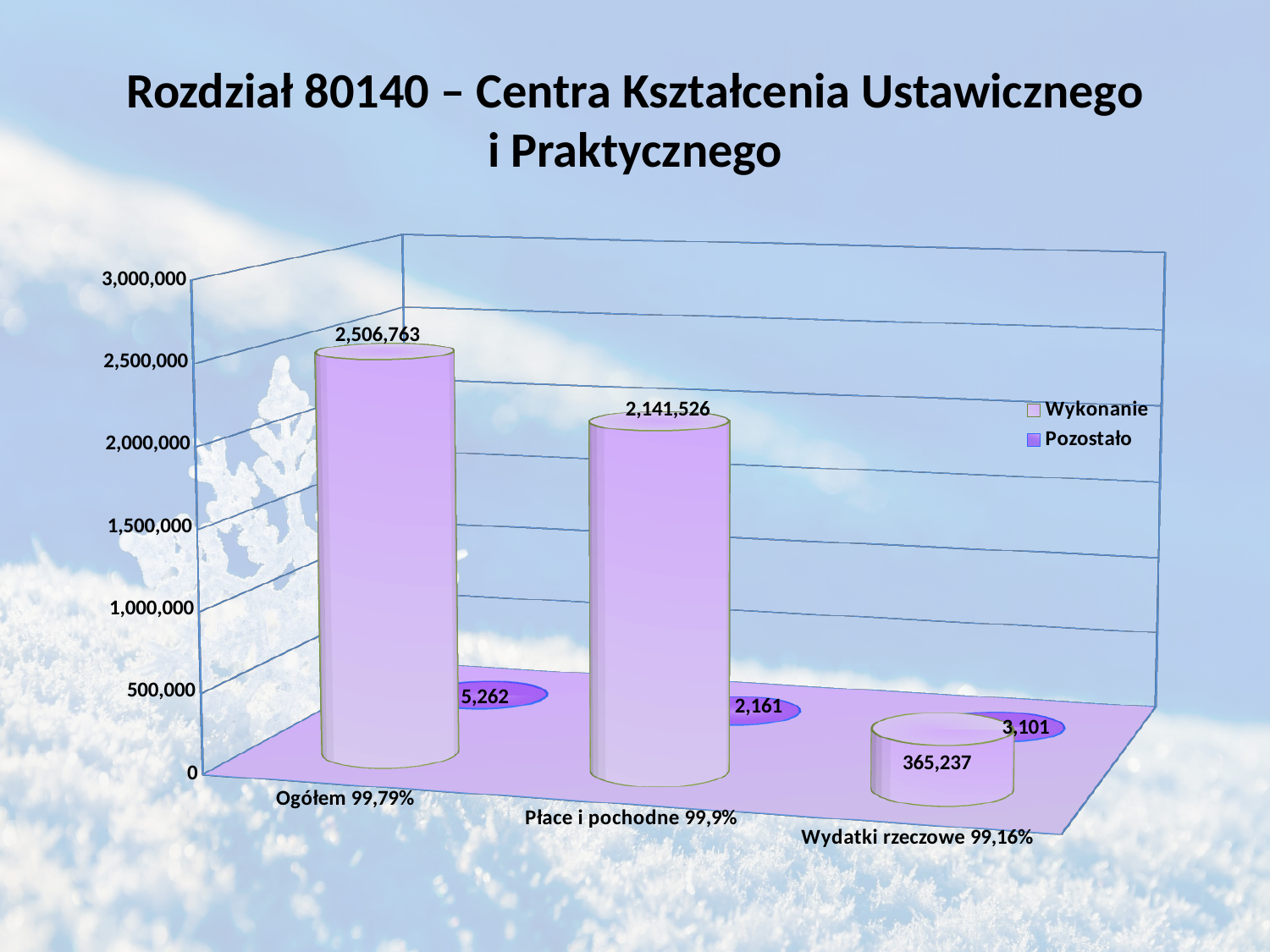
Which category has the lowest Pozostało value? Płace i pochodne 99,9% What is the Pozostało value for Wydatki rzeczowe 99,16%? 3,101 What is the Pozostało value for Ogółem 99,79%? 5,262 Which category has the highest Wykonanie value? Ogółem 99,79% How many categories are shown on the x axis? 3 What is the Wykonanie value for Płace i pochodne 99,9%? 2,141,526 What kind of chart is shown on the slide? Bar chart What is the Wykonanie value for Ogółem 99,79%? 2,506,763 How many series does the legend list? 2 What is the difference between the Wykonanie values for Ogółem 99,79% and Płace i pochodne 99,9%? 365,237 What is the Wykonanie value for Wydatki rzeczowe 99,16%? 365,237 Which is larger, the Pozostało value for Ogółem 99,79% or for Wydatki rzeczowe 99,16%? Ogółem 99,79%